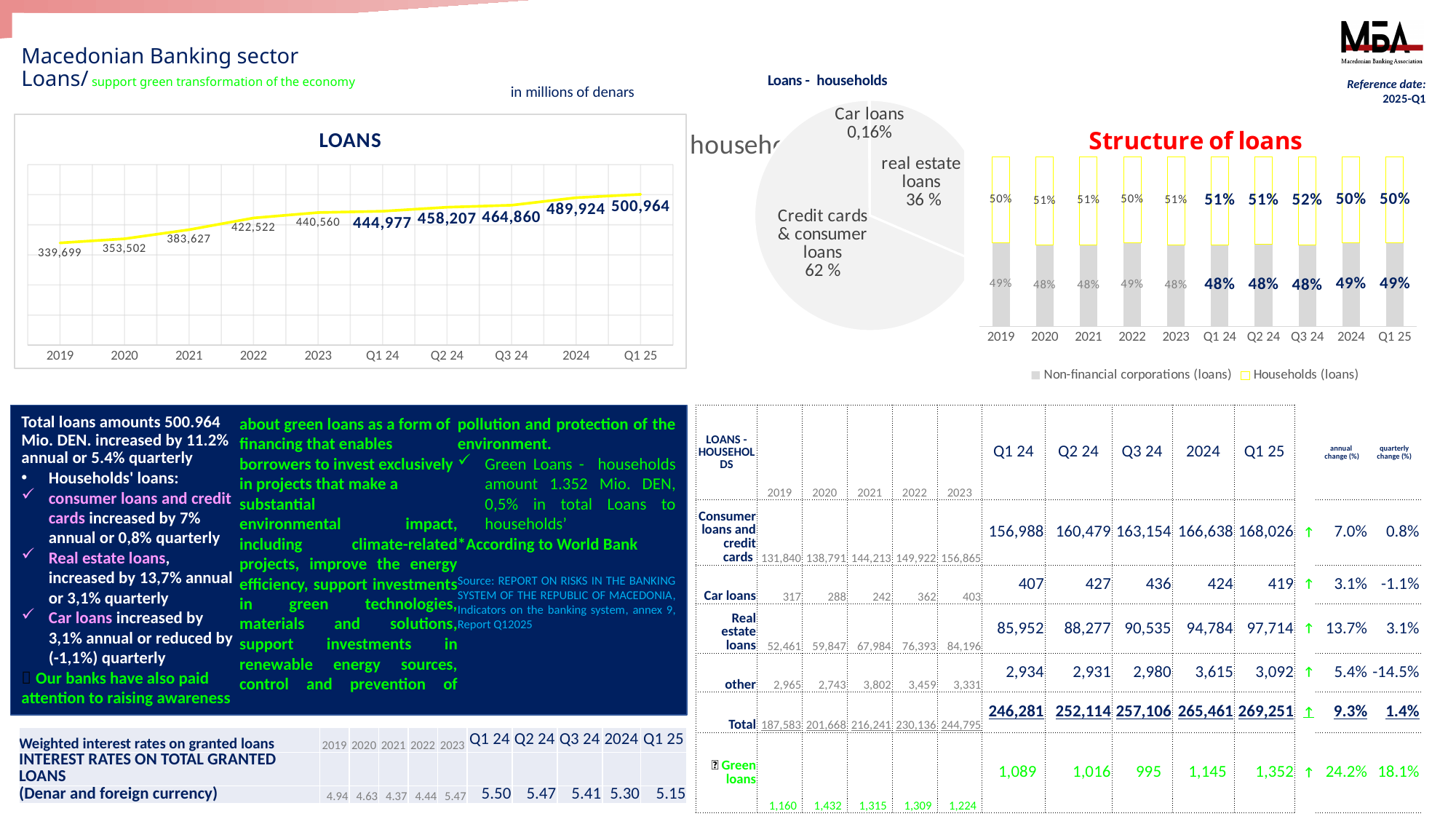
In the Structure of loans chart, what is the Households (loans) share for 2024? 50% In the Loans - households pie chart, which slice is the largest? Credit cards & consumer loans In the LOANS line chart, what is the value for Q1 25? 500,964 In the LOANS line chart, which period has the lowest value? 2019 How many series does the legend of the Structure of loans chart list? 2 In the LOANS line chart, what is the value for 2022? 422,522 In the LOANS line chart, do the values rise or fall from 2019 to Q1 25? rise How many data points are plotted in the LOANS line chart? 10 What kind of chart is the LOANS chart? line chart In the Loans - households pie chart, what share do real estate loans have? 36 % In the LOANS line chart, which period has the highest value? Q1 25 In the LOANS line chart, what is the difference between the 2024 value and the 2023 value? 49,364